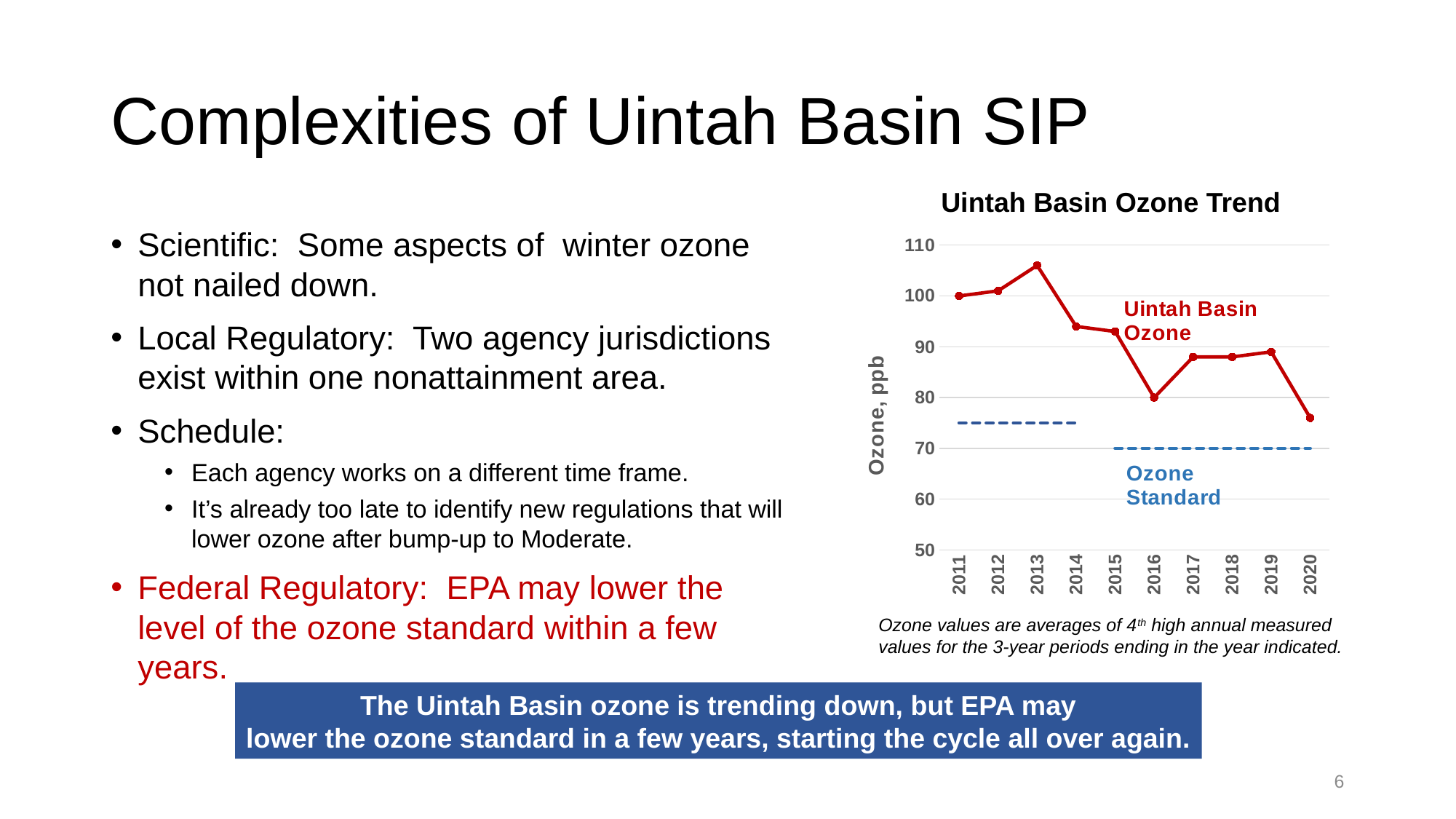
What does the dashed blue line on the chart represent? Ozone Standard Is the Uintah Basin Ozone value for 2013 greater or less than 100? greater What is the title of the chart on the slide? Uintah Basin Ozone Trend Is the Uintah Basin Ozone value for 2014 greater or less than 100? less What kind of chart is the Uintah Basin Ozone Trend chart? line chart Which year has a higher Uintah Basin Ozone value, 2013 or 2020? 2013 Which year has a higher Uintah Basin Ozone value, 2016 or 2017? 2017 In which year is the Uintah Basin Ozone value highest? 2013 Is the Uintah Basin Ozone value for 2020 greater or less than 80? less How many years are shown on the x axis of the chart? 10 In which year is the Uintah Basin Ozone value lowest? 2020 Overall, does the Uintah Basin Ozone value rise or fall from 2011 to 2020? fall